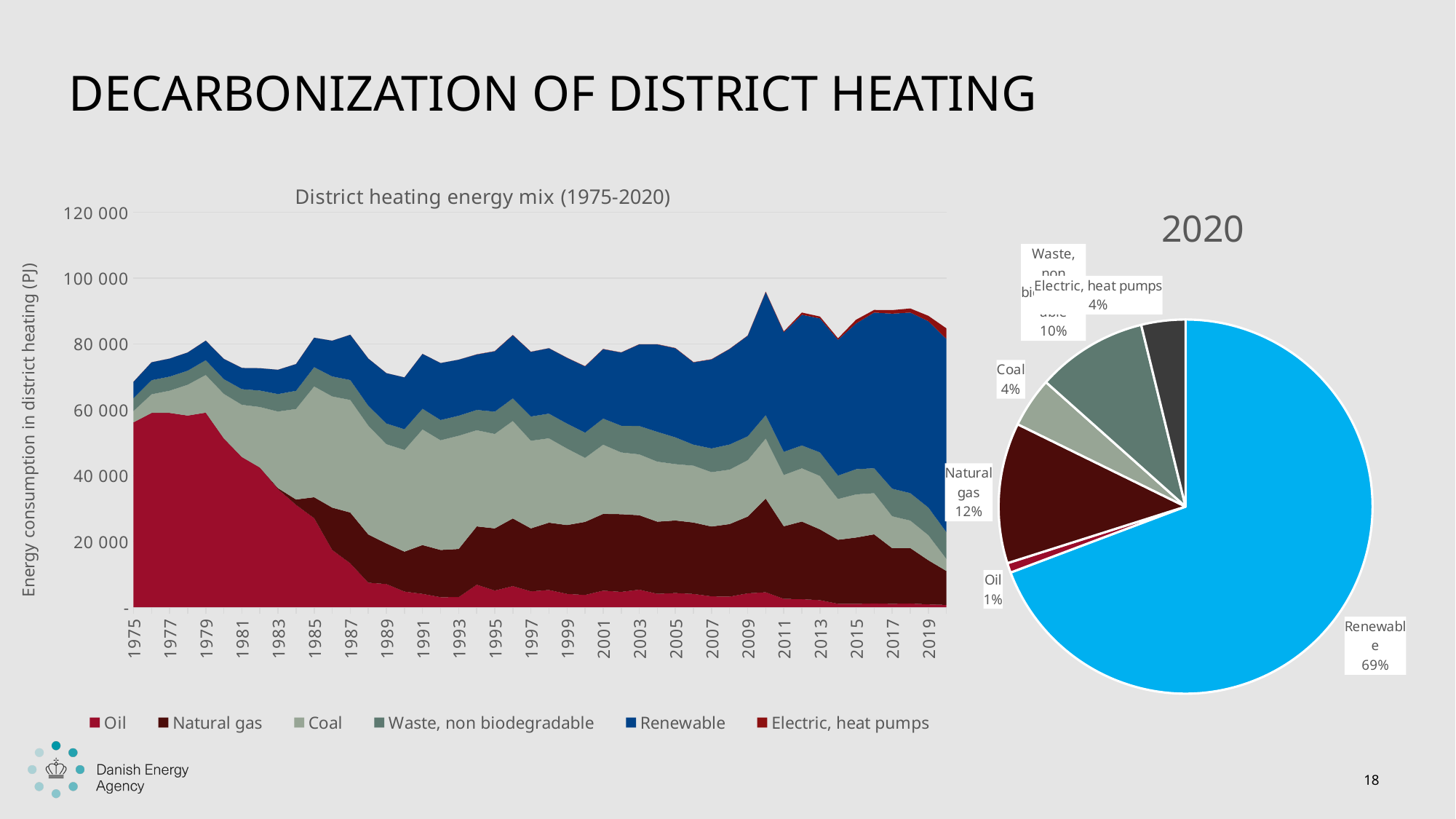
In the District heating energy mix (1975-2020) chart, does the Oil series rise or fall from 1979 to 2019? Fall What kind of chart is the chart titled District heating energy mix (1975-2020)? Stacked area chart In the pie chart titled 2020, what share does Renewable have? 69% How many series does the legend of the District heating energy mix (1975-2020) chart list? 6 In the pie chart titled 2020, what share does Oil have? 1% In the pie chart titled 2020, what is the difference in percentage points between Renewable and Natural gas? 57 In the District heating energy mix (1975-2020) chart, is the total energy consumption in 1975 greater or less than 60 000 PJ? greater In the pie chart titled 2020, which category has the smallest share? Oil In the pie chart titled 2020, what share does Natural gas have? 12% In the pie chart titled 2020, which is larger: Natural gas or Waste, non biodegradable? Natural gas In the pie chart titled 2020, how many slices are there? 6 In the pie chart titled 2020, which category has the largest share? Renewable